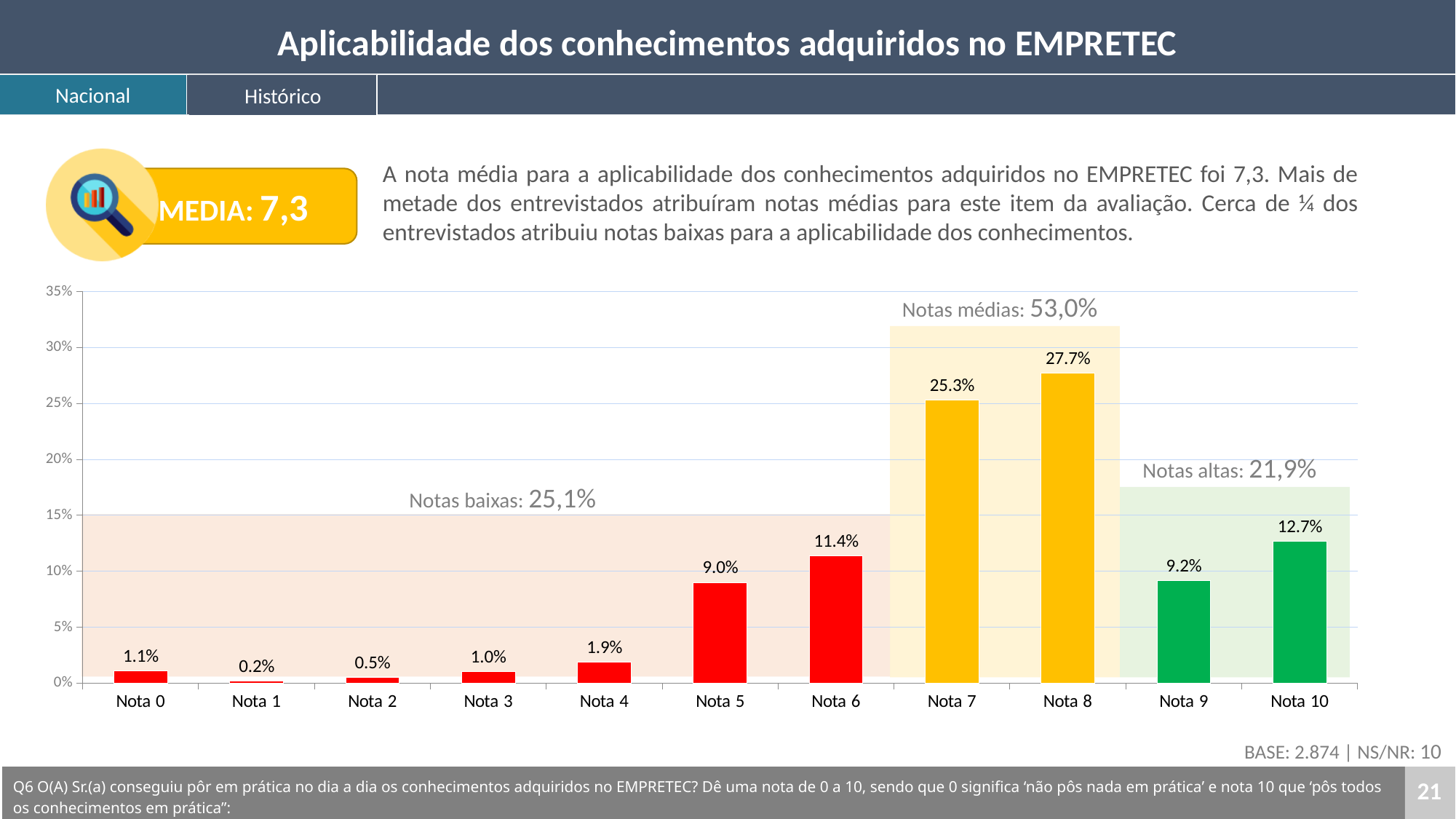
Which is larger, the value for Nota 9 or the value for Nota 5? Nota 9 What colour are the bars for Nota 9 and Nota 10? Green What is the value for Nota 6? 11.4% What is the value for Nota 10? 12.7% Which category has the lowest value? Nota 1 What is the combined share labelled for 'Notas médias' on the chart? 53,0% What is the total of the values for Nota 9 and Nota 10? 21.9% What kind of chart is shown on the slide? Bar chart How many categories are shown on the x axis? 11 What is the difference between the values for Nota 8 and Nota 7? 2.4% Which category has the highest value? Nota 8 What is the value for Nota 8? 27.7%